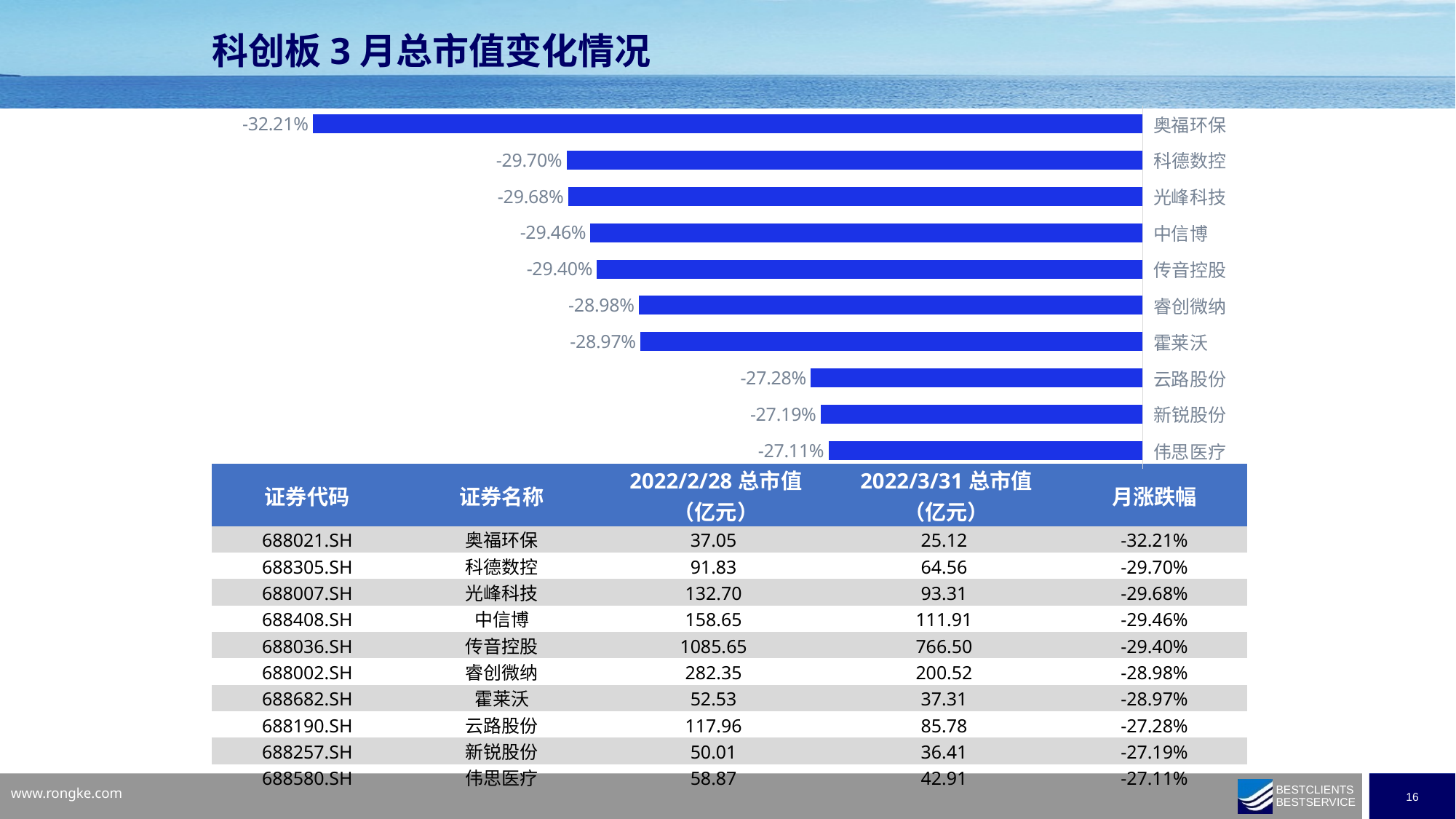
What is the monthly change shown for 奥福环保 in the bar chart? -32.21% What is the monthly change shown for 传音控股 in the bar chart? -29.40% What is the difference in percentage points between the values for 科德数控 (-29.70%) and 云路股份 (-27.28%)? 2.42 percentage points What is the monthly change shown for 云路股份 in the bar chart? -27.28% What is the difference in percentage points between the values for 奥福环保 (-32.21%) and 伟思医疗 (-27.11%)? 5.10 percentage points Which company shows a larger decline in the bar chart, 奥福环保 or 新锐股份? 奥福环保 Which company in the bar chart has the largest decline (the most negative value)? 奥福环保 Which company in the bar chart has the smallest decline (the least negative value)? 伟思医疗 What is the title of the slide containing the chart? 科创板 3 月总市值变化情况 What is the monthly change shown for 霍莱沃 in the bar chart? -28.97% What type of chart is shown on the slide? Bar chart How many companies are shown in the bar chart? 10